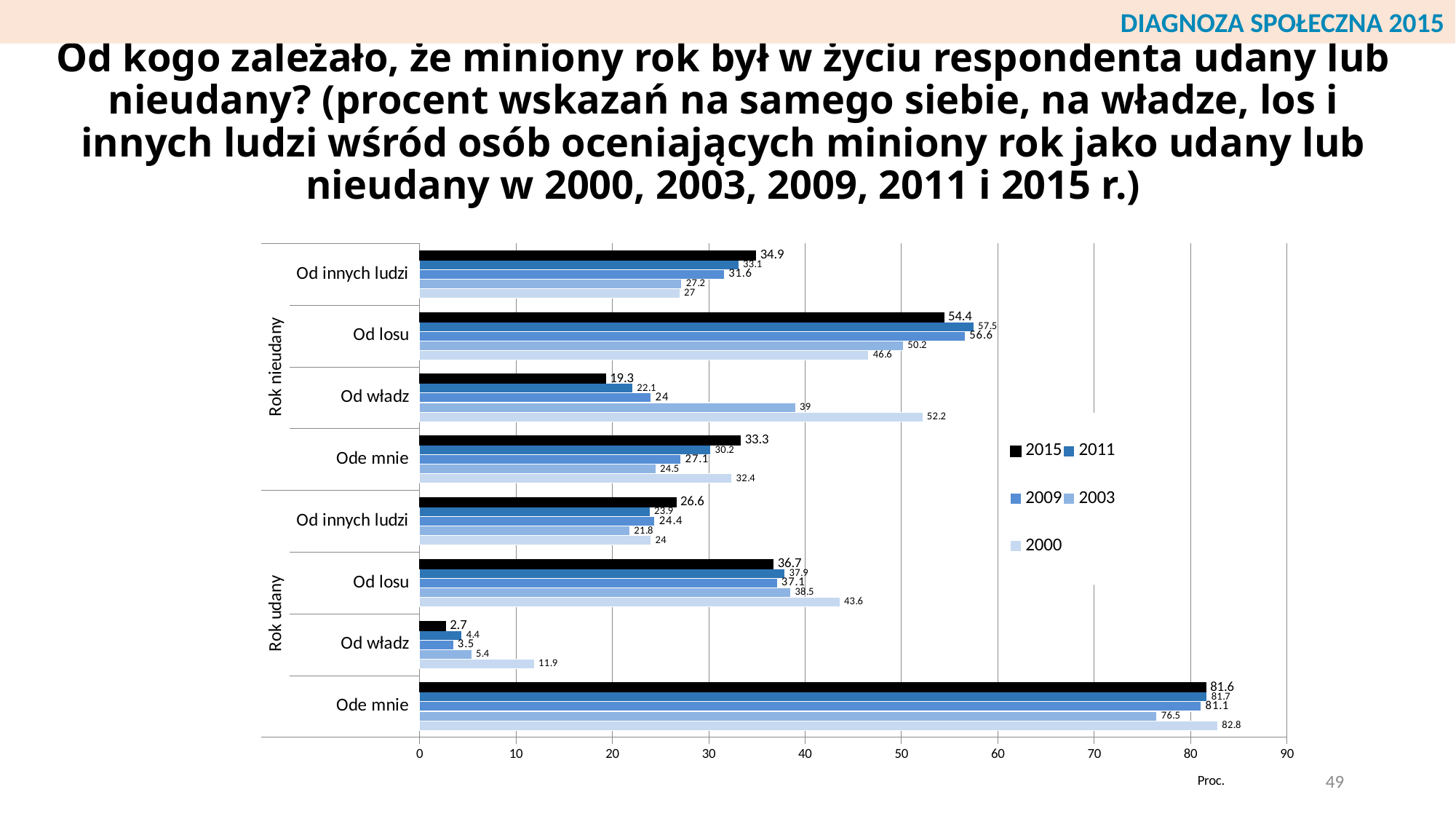
What is the 2011 value for "Od losu" in the "Rok nieudany" group? 57.5 Which year has the highest value for "Od władz" in the "Rok nieudany" group? 2000 In the "Rok udany" group, is the 2000 value for "Od losu" larger than the 2015 value for "Od losu"? Yes, 43.6 vs 36.7 What is the 2003 value for "Od władz" in the "Rok udany" group? 5.4 What is the difference between the 2000 and 2015 values for "Od władz" in the "Rok nieudany" group? 32.9 What unit label is shown below the horizontal axis? Proc. What kind of chart is shown on the slide? Bar chart Which year has the lowest value for "Od władz" in the "Rok udany" group? 2015 What is the 2000 value for "Od władz" in the "Rok nieudany" group? 52.2 How many series does the legend list? 5 Is the 2015 value for "Od losu" in the "Rok nieudany" group greater or less than 50? greater What is the 2015 value for "Ode mnie" in the "Rok udany" group? 81.6